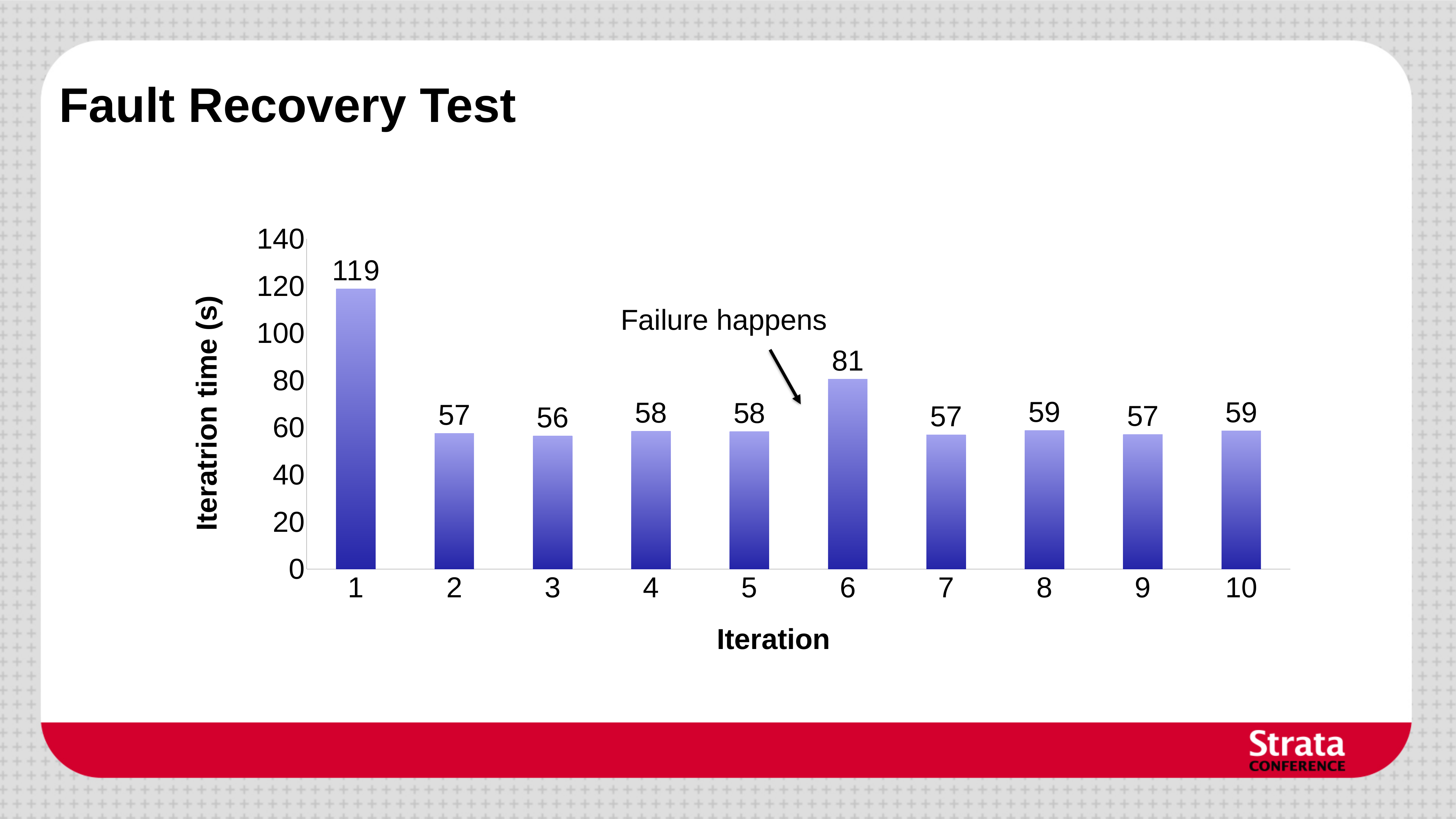
What is the difference in iteration time between iteration 1 and iteration 2? 62 What event does the annotation arrow on the chart point to? Failure happens What is the iteration time for iteration 3? 56 What kind of chart is shown on the slide? Bar chart What is the iteration time for iteration 6? 81 What is the iteration time for iteration 1? 119 What is the difference in iteration time between iteration 6 and iteration 7? 24 Which has a larger iteration time, iteration 6 or iteration 8? Iteration 6 Is the value for iteration 1 greater or less than 100? greater How many iterations are shown on the x axis? 10 Which iteration has the highest iteration time? 1 Which iteration has the lowest iteration time? 3